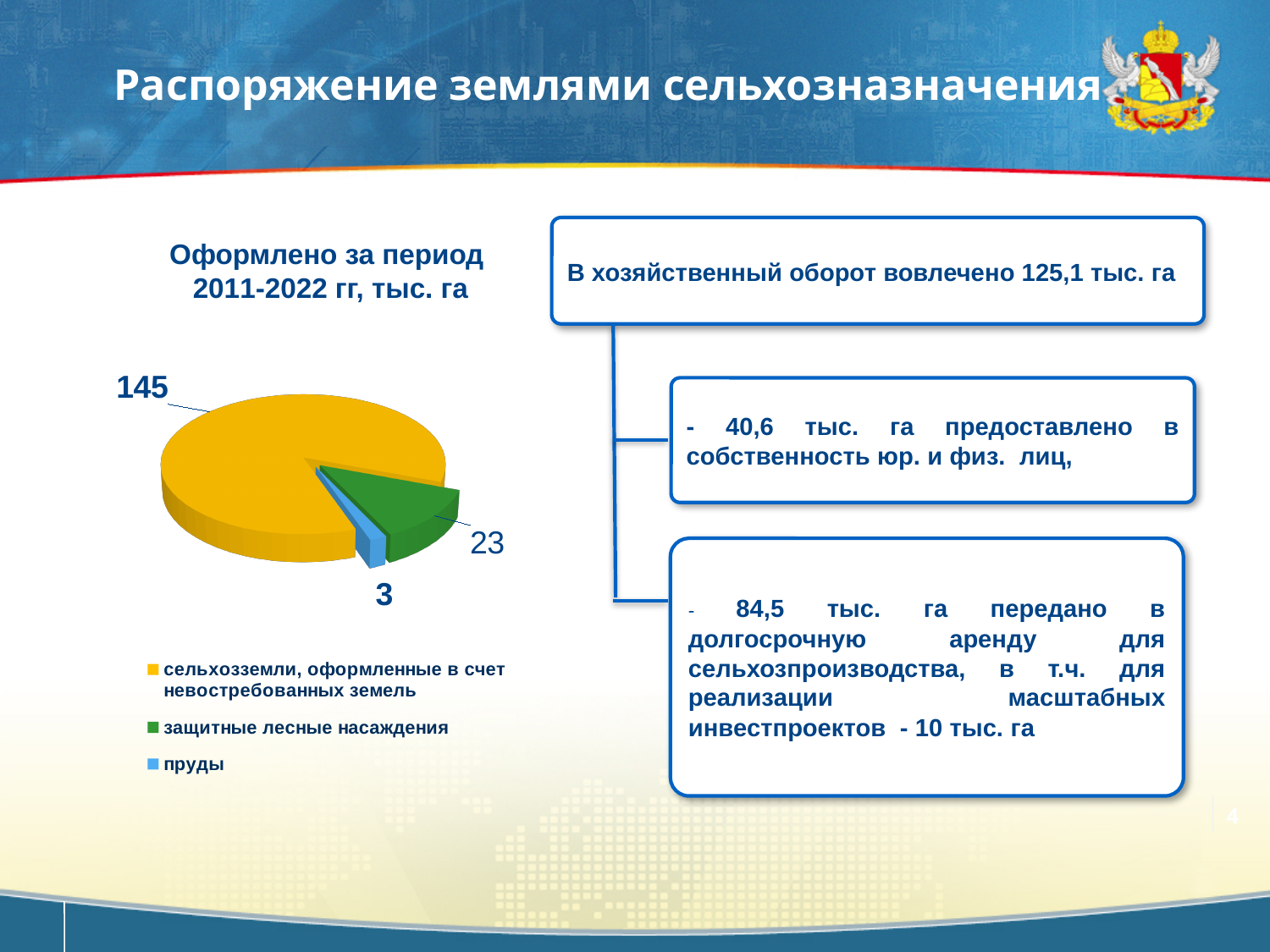
Which is larger: the value for 'защитные лесные насаждения' or the value for 'пруды'? защитные лесные насаждения How many entries does the legend of the pie chart list? 3 What is the total of all slices in the pie chart? 171 What kind of chart is shown on the slide? pie chart What is the title of the pie chart? Оформлено за период 2011-2022 гг, тыс. га How many slices does the pie chart have? 3 Which category has the smallest slice in the pie chart? пруды What is the value for 'пруды' in the pie chart? 3 What is the value for 'сельхозземли, оформленные в счет невостребованных земель' in the pie chart? 145 Which category has the largest slice in the pie chart? сельхозземли, оформленные в счет невостребованных земель What is the difference between the values for 'сельхозземли, оформленные в счет невостребованных земель' and 'защитные лесные насаждения'? 122 What is the value for 'защитные лесные насаждения' in the pie chart? 23